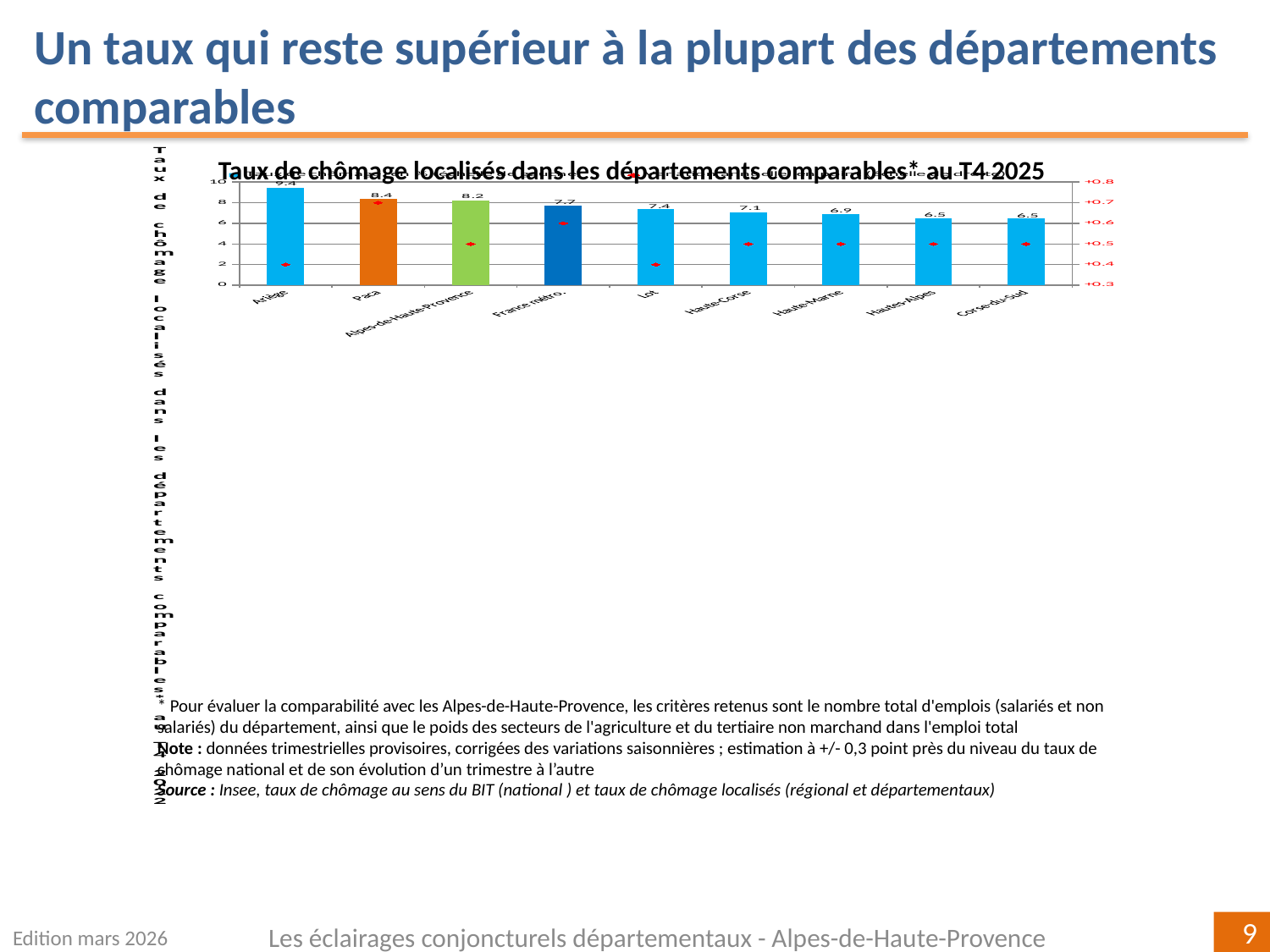
Do the bar values rise or fall from left to right along the x axis? Fall What kind of chart is this? Bar chart What is the unemployment rate shown for Ariège? 9.4 What is the value shown for Alpes-de-Haute-Provence? 8.2 Which has a higher value, Lot or Haute-Corse? Lot What colour is the bar for Paca? Orange What is the value shown for Haute-Marne? 6.9 What is the difference between the values for Alpes-de-Haute-Provence and France métro.? 0.5 What is the difference between the values for Ariège and Paca? 1.0 What is the value shown for France métro.? 7.7 How many categories are shown on the x axis? 9 Which category has the highest bar? Ariège